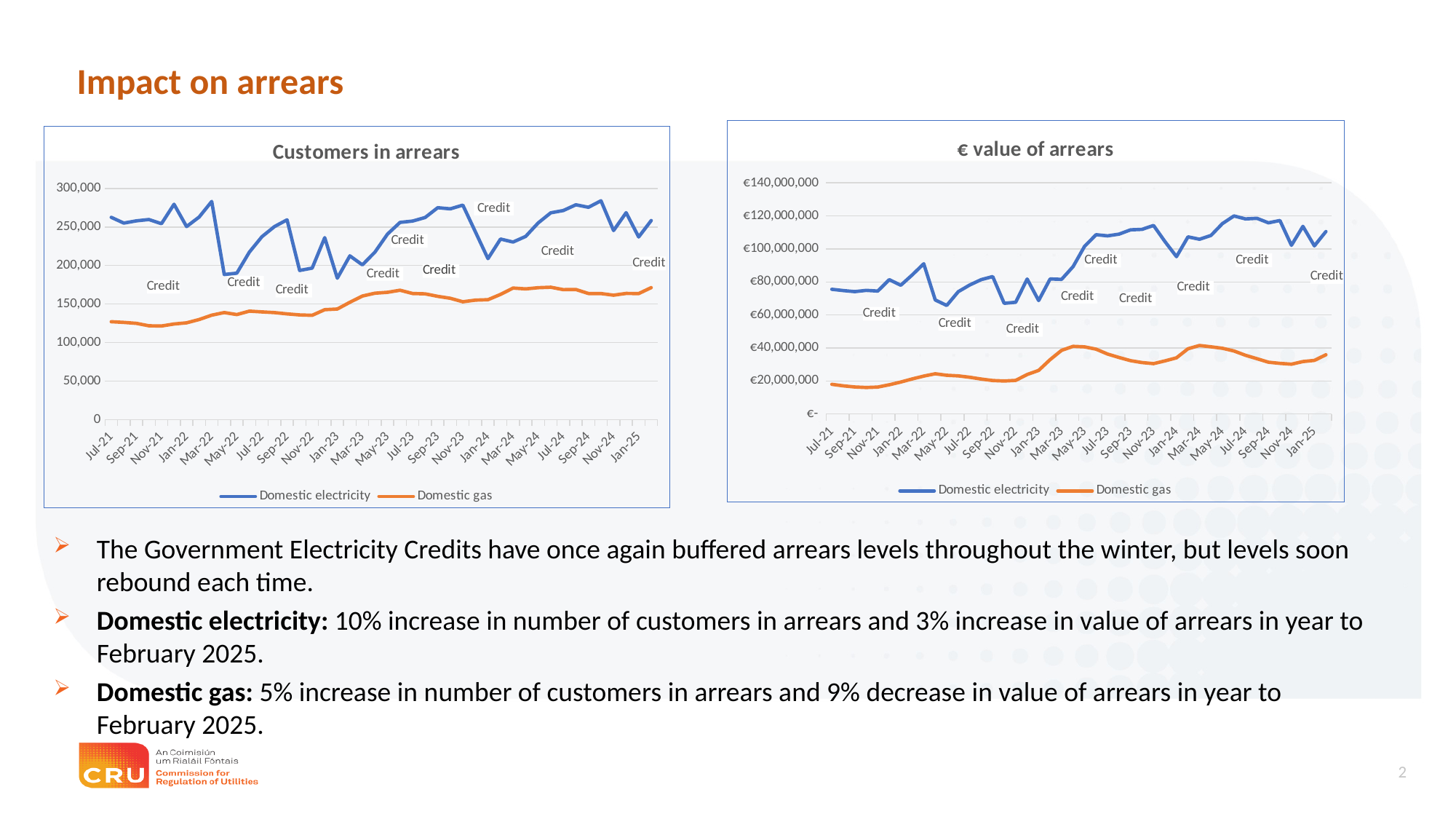
What kind of chart is the "Customers in arrears" chart? Line chart What is the title of the chart on the right of the slide? € value of arrears How many series does the legend of the "Customers in arrears" chart list? 2 In the "Customers in arrears" chart, which series is higher at Jan-25, Domestic electricity or Domestic gas? Domestic electricity In the "€ value of arrears" chart, which series is higher at Mar-23, Domestic electricity or Domestic gas? Domestic electricity In the "€ value of arrears" chart, is the value for Domestic gas at Jul-21 greater or less than €40,000,000? less In the "Customers in arrears" chart, is the value for Domestic gas at Jul-21 greater or less than 150,000? less In the "Customers in arrears" chart, does the Domestic gas line overall rise or fall from Jul-21 to Jan-25? Rise In the "€ value of arrears" chart, which series is plotted in orange? Domestic gas What kind of chart is the "€ value of arrears" chart? Line chart In the "Customers in arrears" chart, is the value for Domestic electricity at Jul-21 greater or less than 200,000? greater